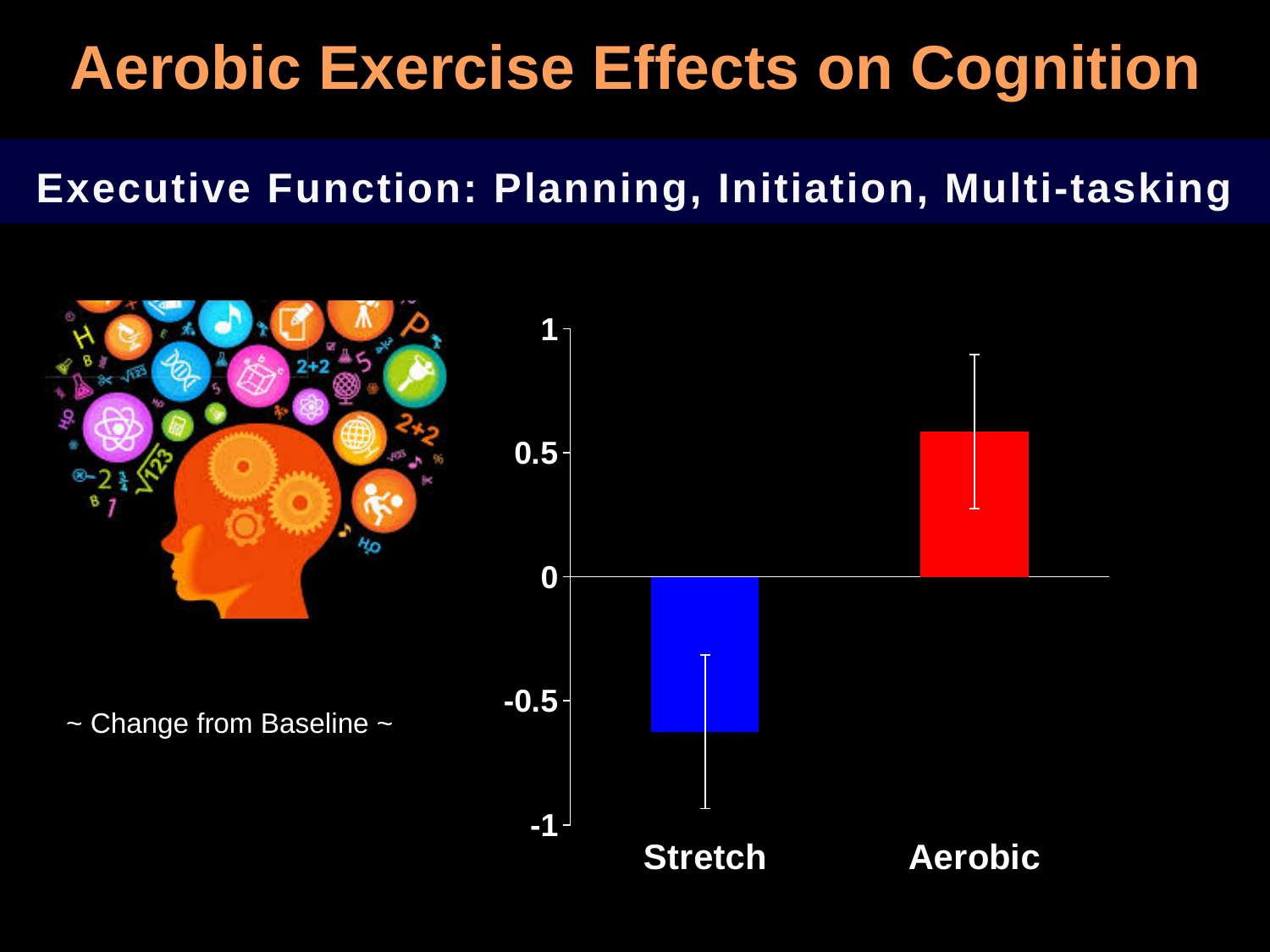
Is the value for Aerobic greater or less than 0? greater Do the values rise or fall moving from Stretch to Aerobic along the x axis? rise Which has the larger value, Stretch or Aerobic? Aerobic What colour is the bar for Stretch? blue What kind of chart is shown on the slide? bar chart Is the value for Stretch greater or less than 0? less Which category has the highest value in the chart? Aerobic Is the value for Aerobic greater or less than 0.5? greater How many categories are plotted on the x axis of the chart? 2 What colour is the bar for Aerobic? red Which category has the lowest value in the chart? Stretch